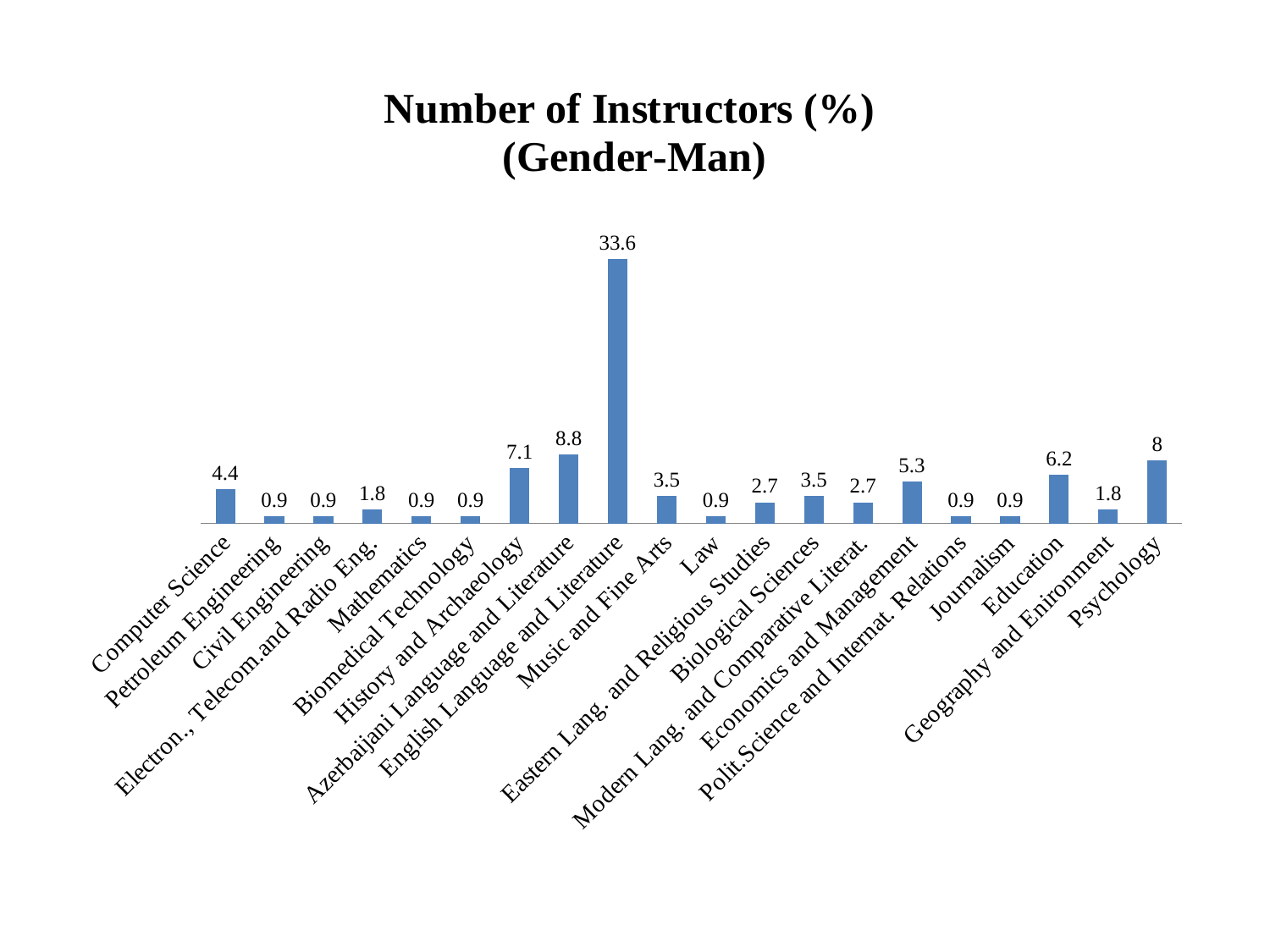
What is the value for Computer Science? 4.4 What is the difference between the values for English Language and Literature and Azerbaijani Language and Literature? 24.8 What is the value for English Language and Literature? 33.6 What type of chart is shown on the slide? bar chart What is the difference between the values for Education and Computer Science? 1.8 What is the title of the chart? Number of Instructors (%) (Gender-Man) Which is larger, the value for History and Archaeology or the value for Education? History and Archaeology What is the value for Economics and Management? 5.3 How many categories are shown in the chart? 20 What is the lowest value shown in the chart? 0.9 What is the value for Psychology? 8 Which category has the highest value? English Language and Literature